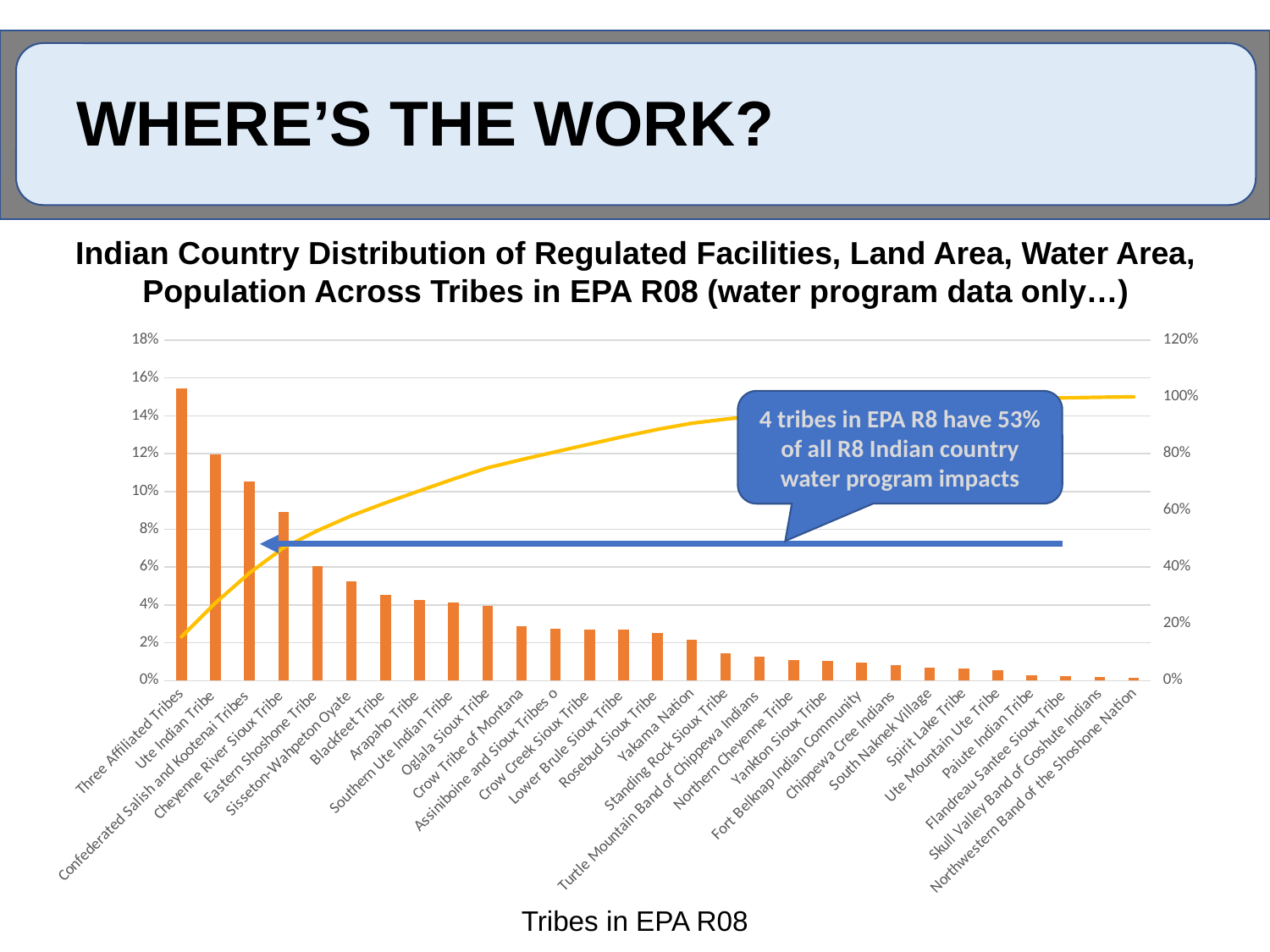
Which tribe has the highest bar in the chart? Three Affiliated Tribes Is the bar value for Standing Rock Sioux Tribe greater or less than 2%? less Is the bar value for Sisseton-Wahpeton Oyate greater or less than 6%? less What is the x-axis title of the chart? Tribes in EPA R08 What kind of chart is shown on the slide? Bar chart with a line Is the bar value for Cheyenne River Sioux Tribe greater or less than 8%? greater How many tribes are shown along the x axis of the chart? 29 According to the callout on the chart, what share of all R8 Indian country water program impacts do 4 tribes have? 53% Which has the larger bar, Ute Indian Tribe or Blackfeet Tribe? Ute Indian Tribe Do the bar values rise or fall moving left to right along the x axis? Fall